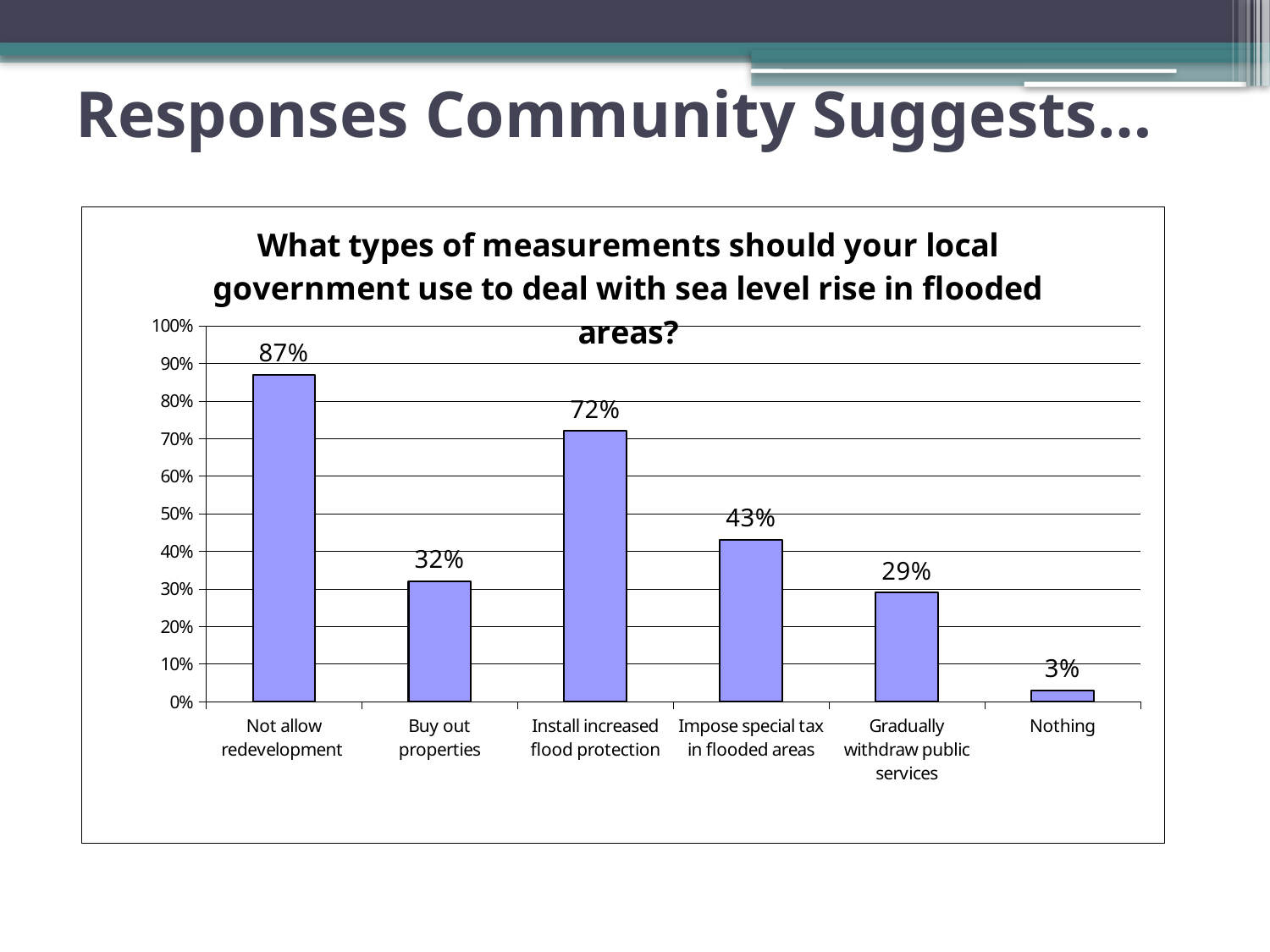
Which category has the lowest value? Nothing How many categories are shown on the chart? 6 What is the difference between "Impose special tax in flooded areas" and "Buy out properties"? 11% What is the difference between "Not allow redevelopment" and "Install increased flood protection"? 15% What is the value for "Install increased flood protection"? 72% What percentage of respondents chose "Not allow redevelopment"? 87% Which is larger: "Buy out properties" or "Impose special tax in flooded areas"? Impose special tax in flooded areas What is the title of the chart? What types of measurements should your local government use to deal with sea level rise in flooded areas? Is the value for "Gradually withdraw public services" greater or less than 30%? less Which category has the highest value? Not allow redevelopment What is the value for "Gradually withdraw public services"? 29% What kind of chart is shown on the slide? bar chart